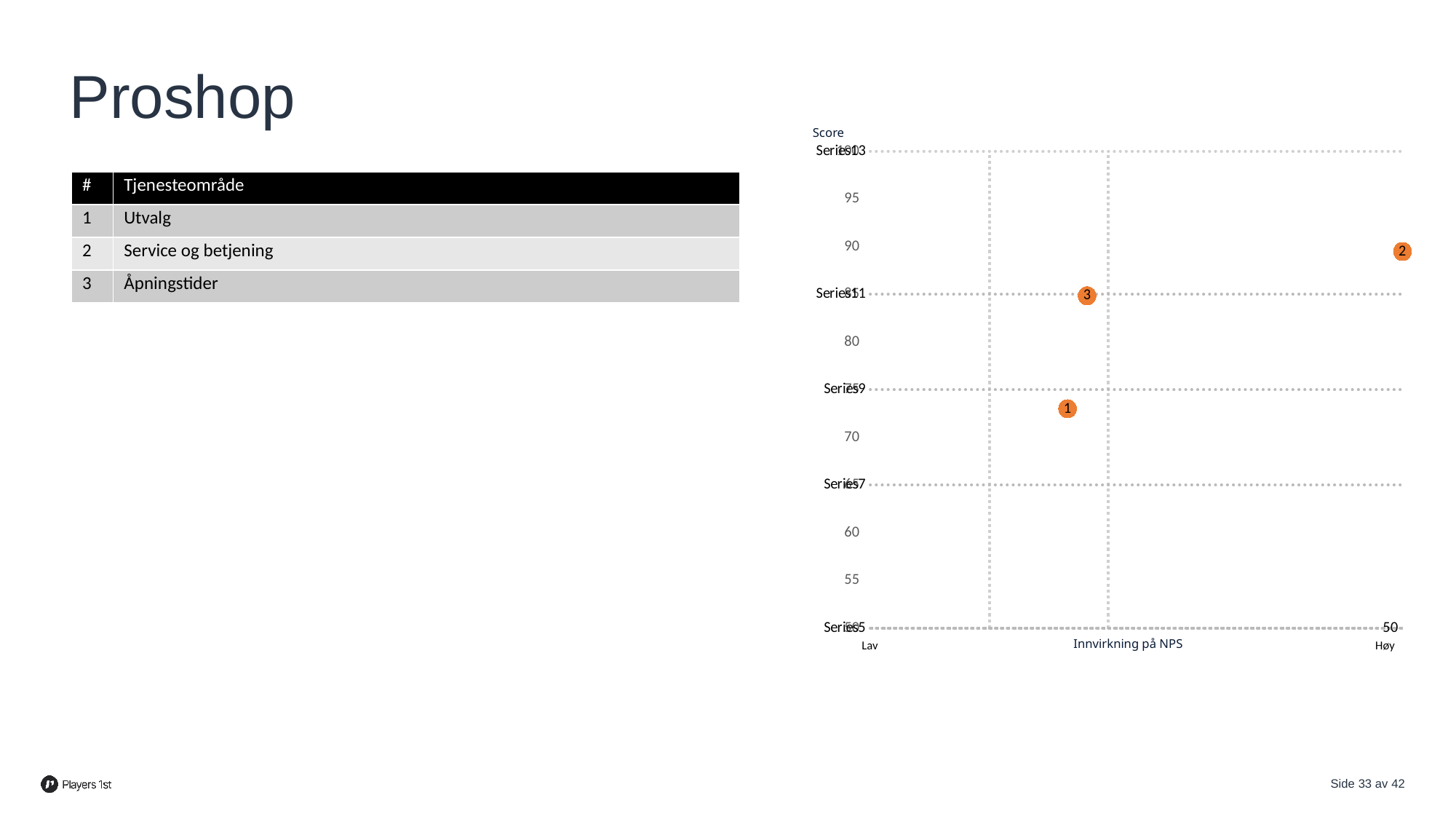
What is the label of the horizontal axis of the chart? Innvirkning på NPS Is the score for point 1 greater or less than 80? less Which service area (per the table) has the highest score on the chart? Service og betjening Which numbered point has the highest score on the chart? 2 What kind of chart is shown on the right of the slide? scatter chart Which point lies furthest to the right (highest impact on NPS) on the chart? 2 Which has a higher score on the chart, point 1 or point 3? 3 Is the score for point 3 greater or less than 80? greater What is the label of the vertical axis of the chart? Score How many data points are plotted on the chart? 3 Is the score for point 2 greater or less than 85? greater Which numbered point has the lowest score on the chart? 1